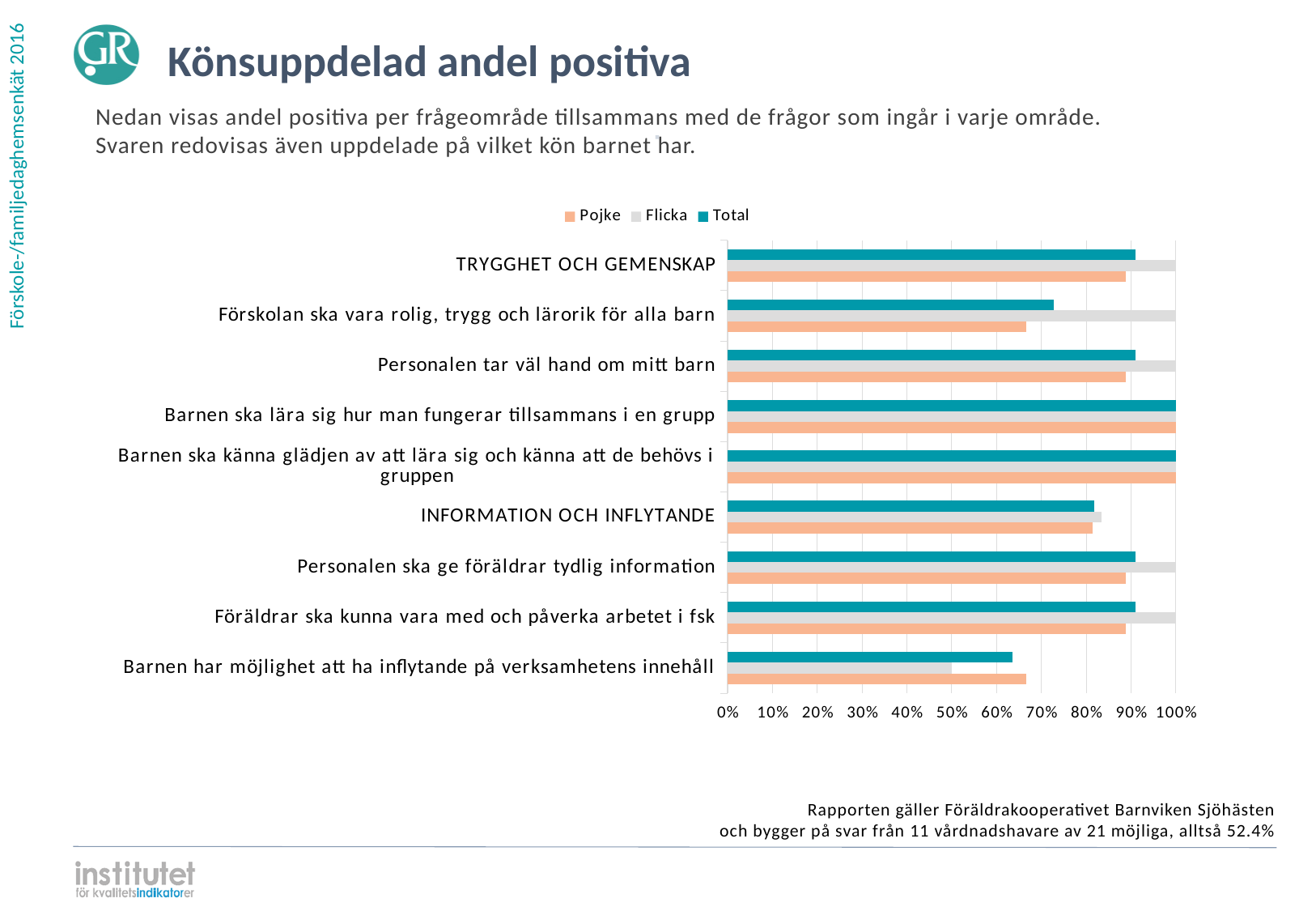
Is the Pojke value for 'Barnen har möjlighet att ha inflytande på verksamhetens innehåll' greater or less than 60%? greater How many categories are plotted on the y axis of the chart? 9 Is the Total value for 'INFORMATION OCH INFLYTANDE' greater or less than 80%? greater How many series does the legend list? 3 Is the Pojke value for 'Förskolan ska vara rolig, trygg och lärorik för alla barn' greater or less than 70%? less What is the Flicka value for 'Barnen har möjlighet att ha inflytande på verksamhetens innehåll'? 50% What is the Total value for 'Barnen ska lära sig hur man fungerar tillsammans i en grupp'? 100% Which category has the lowest Flicka value? Barnen har möjlighet att ha inflytande på verksamhetens innehåll What kind of chart is shown on the slide? bar chart What is the Flicka value for 'TRYGGHET OCH GEMENSKAP'? 100% For 'Barnen har möjlighet att ha inflytande på verksamhetens innehåll', which is larger: the Pojke value or the Flicka value? Pojke Which series is shown in grey in the legend? Flicka